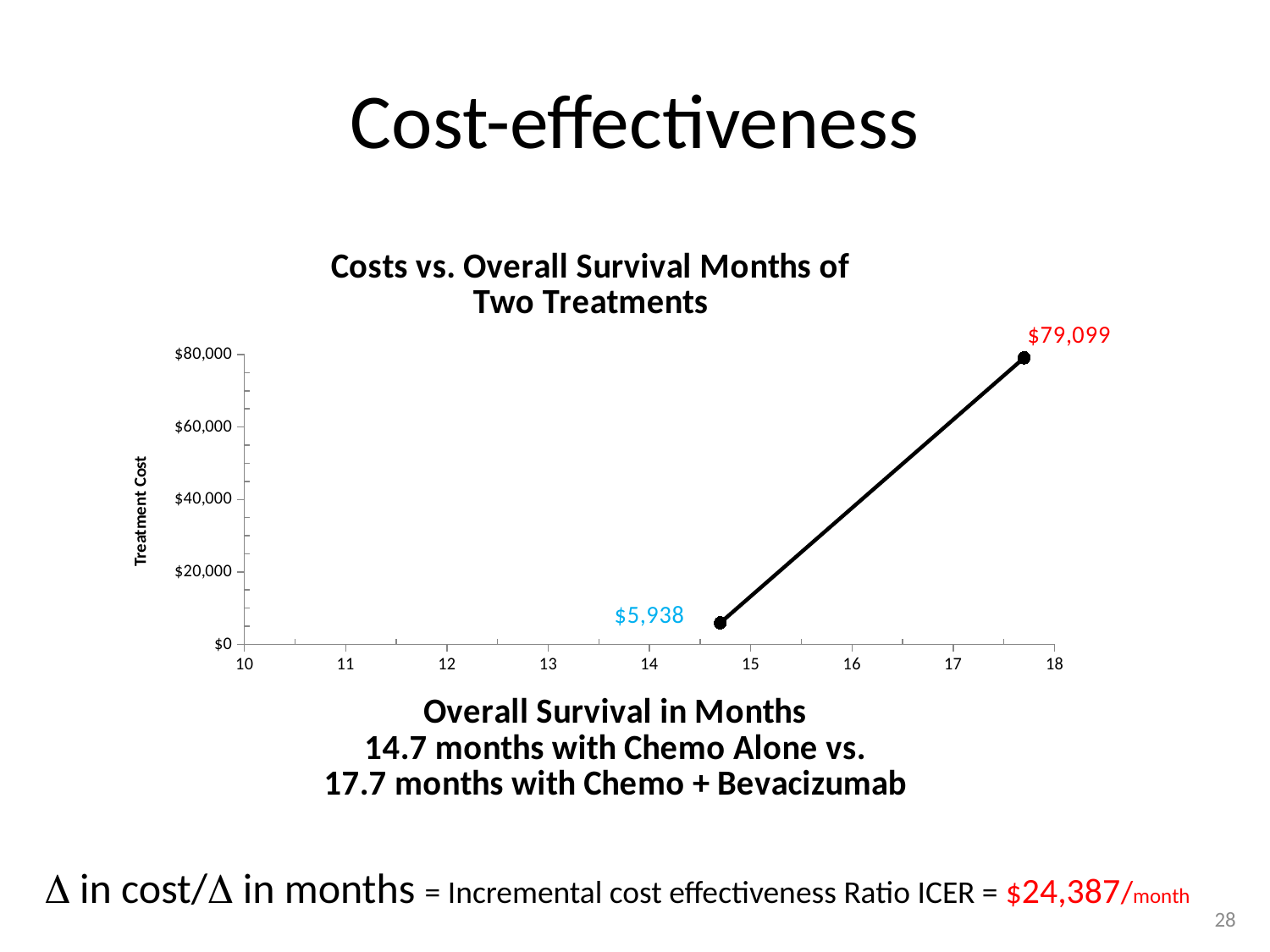
Which treatment has the higher plotted treatment cost? Chemo + Bevacizumab Is the treatment cost for Chemo Alone greater or less than $20,000? less What is the treatment cost plotted for Chemo + Bevacizumab (17.7 months)? $79,099 What is the treatment cost plotted for Chemo Alone (14.7 months)? $5,938 What is the title of the chart? Costs vs. Overall Survival Months of Two Treatments Does treatment cost rise or fall as overall survival in months increases along the x axis? rise How many data points are plotted on the chart? 2 What is the label of the vertical axis? Treatment Cost Is the treatment cost for Chemo + Bevacizumab greater or less than $60,000? greater What kind of chart is shown on the slide? line chart Which treatment has the lower plotted treatment cost? Chemo Alone What is the difference in treatment cost between Chemo + Bevacizumab and Chemo Alone? $73,161